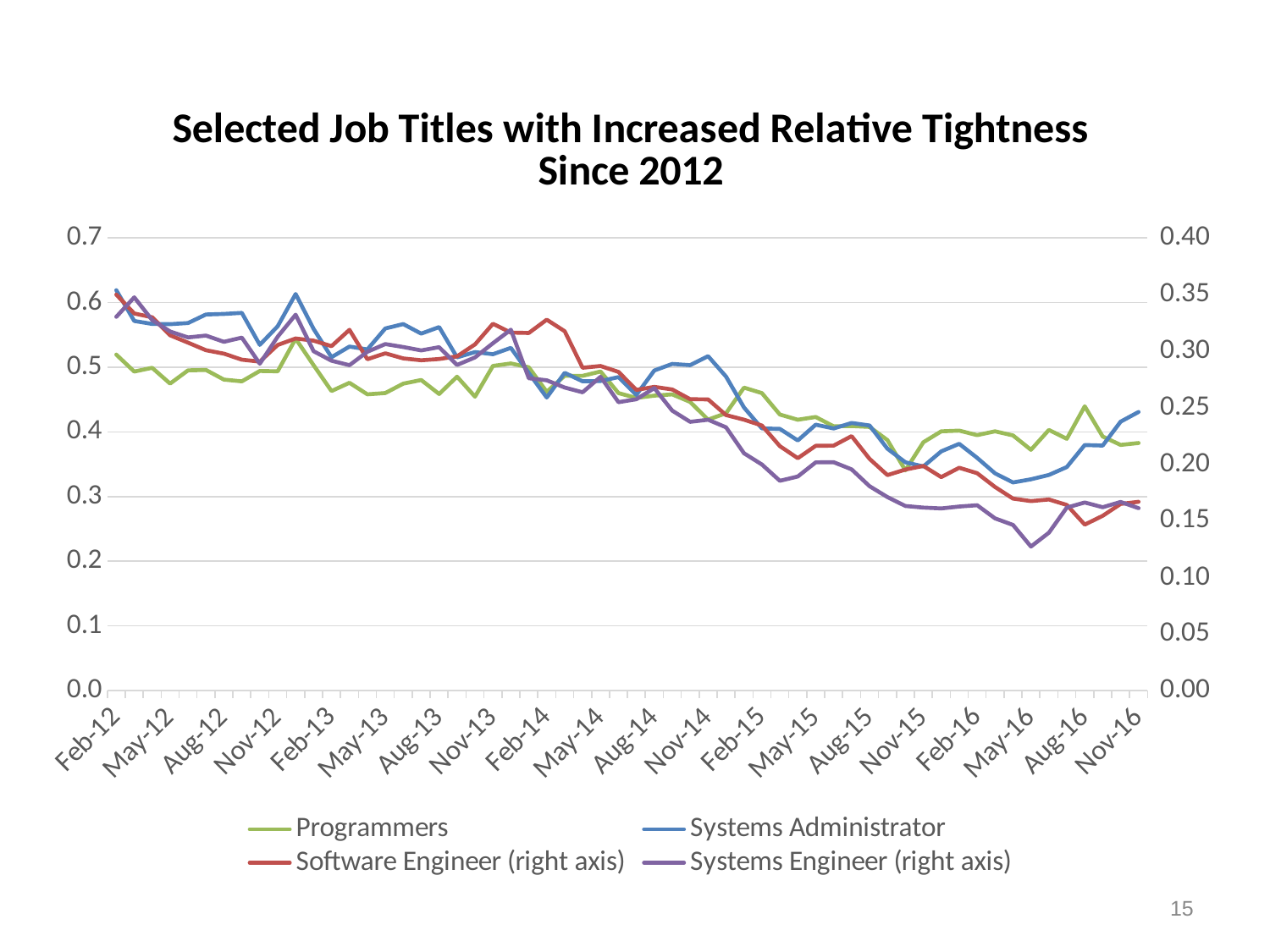
Does the Systems Engineer (right axis) series generally rise or fall from Feb-12 to Nov-16? fall Does the Programmers series generally rise or fall from Feb-12 to Nov-16? fall Is the value for Systems Administrator in Nov-16 greater or less than 0.5? less Which two series are plotted on the right axis? Software Engineer and Systems Engineer How many series does the legend list? 4 What type of chart is shown on the slide? line chart What is the title of the chart? Selected Job Titles with Increased Relative Tightness Since 2012 Is the value for Systems Engineer (right axis) in May-16 greater or less than 0.15? less In Feb-12, which is higher on the left axis: Programmers or Systems Administrator? Systems Administrator Is the value for Software Engineer (right axis) in Nov-16 greater or less than 0.20? less